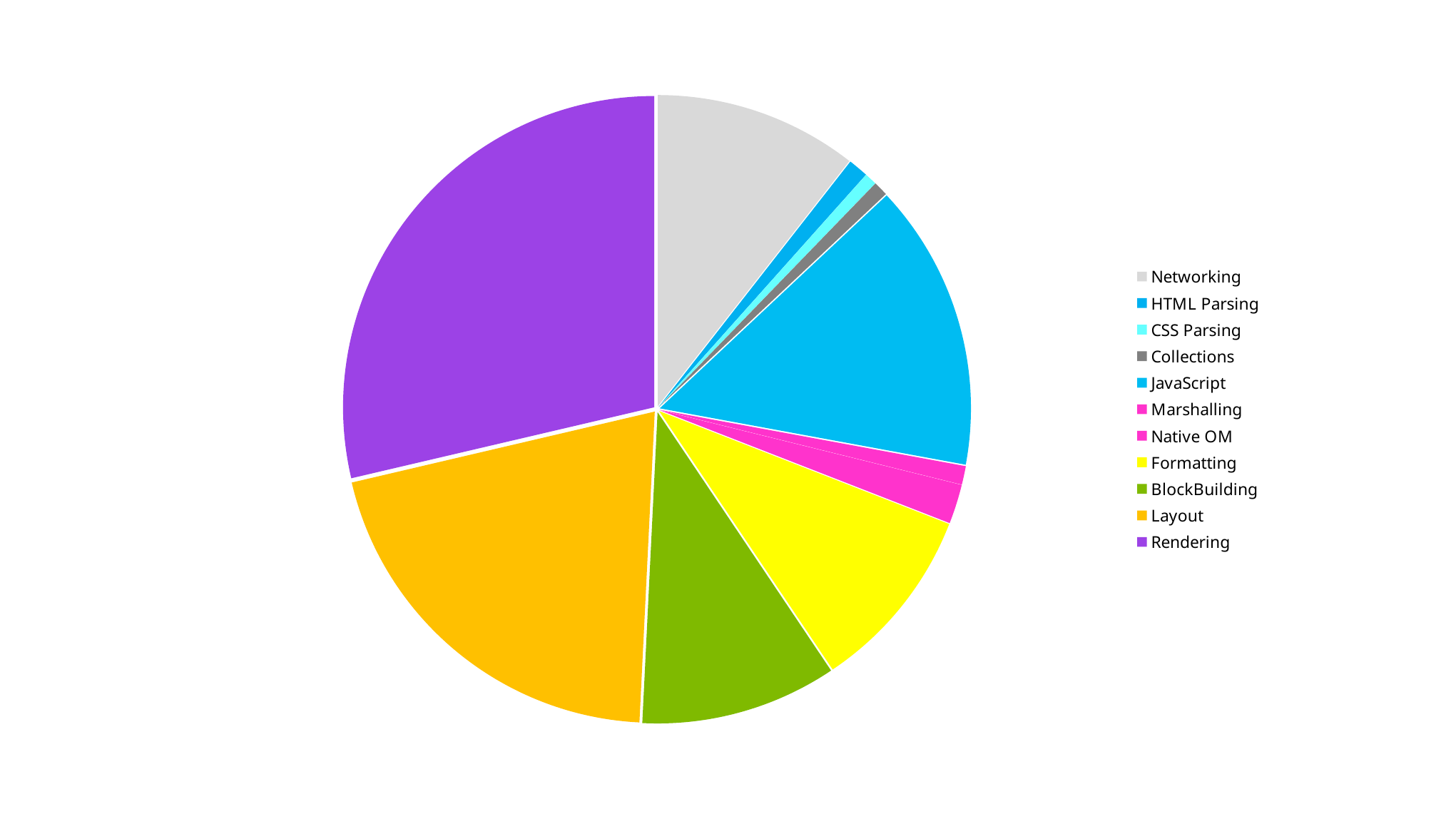
Which category has the largest slice of the pie? Rendering Which slice is larger, JavaScript or Native OM? JavaScript What kind of chart is shown on the slide? pie chart Which slice is larger, Rendering or Layout? Rendering Which category is listed first in the legend? Networking Which slice is larger, Layout or BlockBuilding? Layout How many entries does the legend list? 11 What colour is the Rendering slice? purple How many slices does the pie chart have? 11